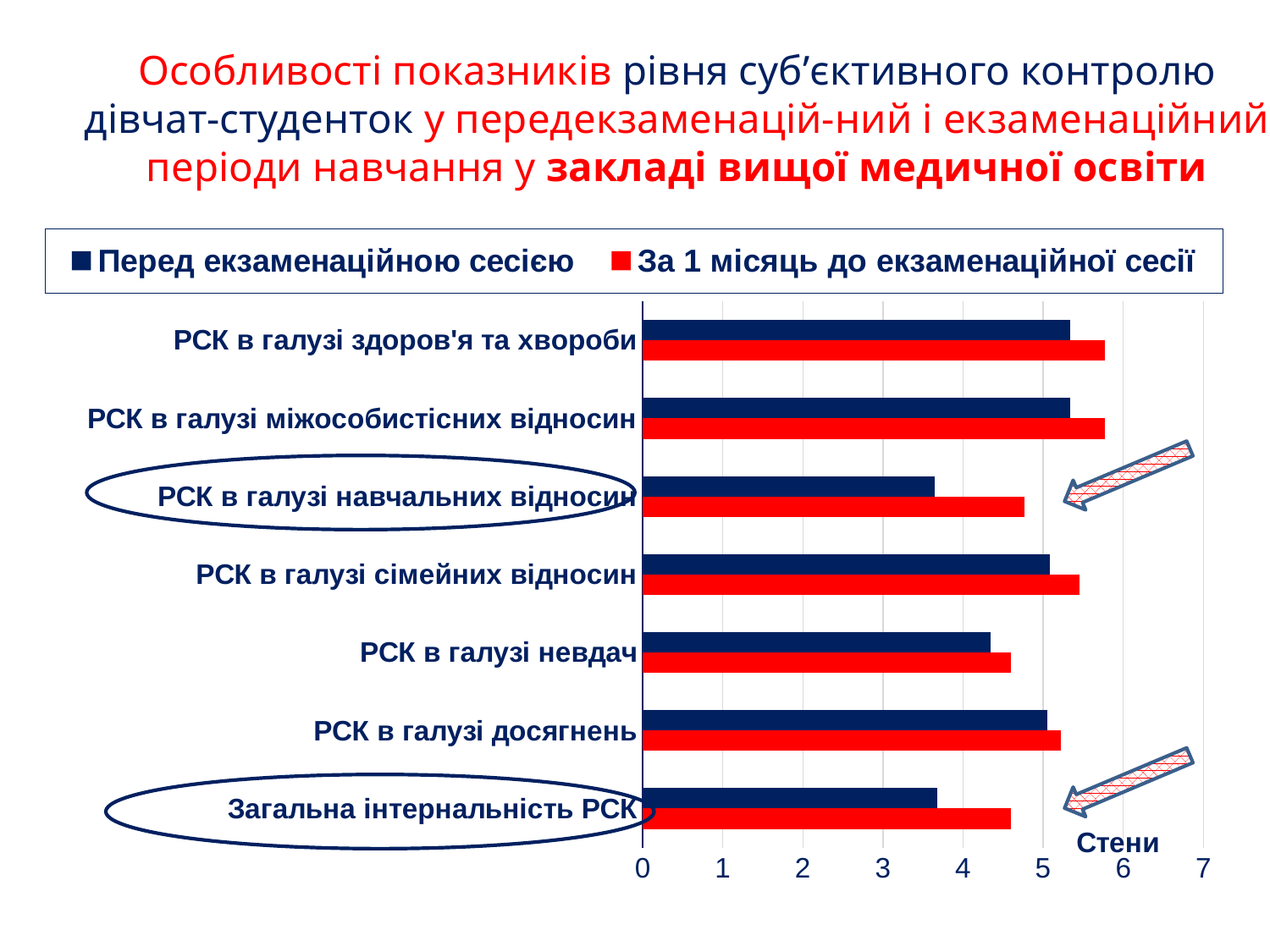
Is the value for 'За 1 місяць до екзаменаційної сесії' in the category 'РСК в галузі сімейних відносин' greater or less than 5? greater What kind of chart is shown on the slide? Bar chart What unit label is shown next to the horizontal axis of the chart? Стени How many series does the legend list? 2 Which colour represents the series 'За 1 місяць до екзаменаційної сесії' in the chart? Red How many categories are plotted on the chart? 7 Is the value for 'Перед екзаменаційною сесією' in the category 'РСК в галузі навчальних відносин' greater or less than 4? less In the category 'Загальна інтернальність РСК', which series has the larger value: 'Перед екзаменаційною сесією' or 'За 1 місяць до екзаменаційної сесії'? За 1 місяць до екзаменаційної сесії Is the value for 'За 1 місяць до екзаменаційної сесії' in the category 'РСК в галузі здоров'я та хвороби' greater or less than 5? greater In the category 'РСК в галузі навчальних відносин', which series has the larger value: 'Перед екзаменаційною сесією' or 'За 1 місяць до екзаменаційної сесії'? За 1 місяць до екзаменаційної сесії